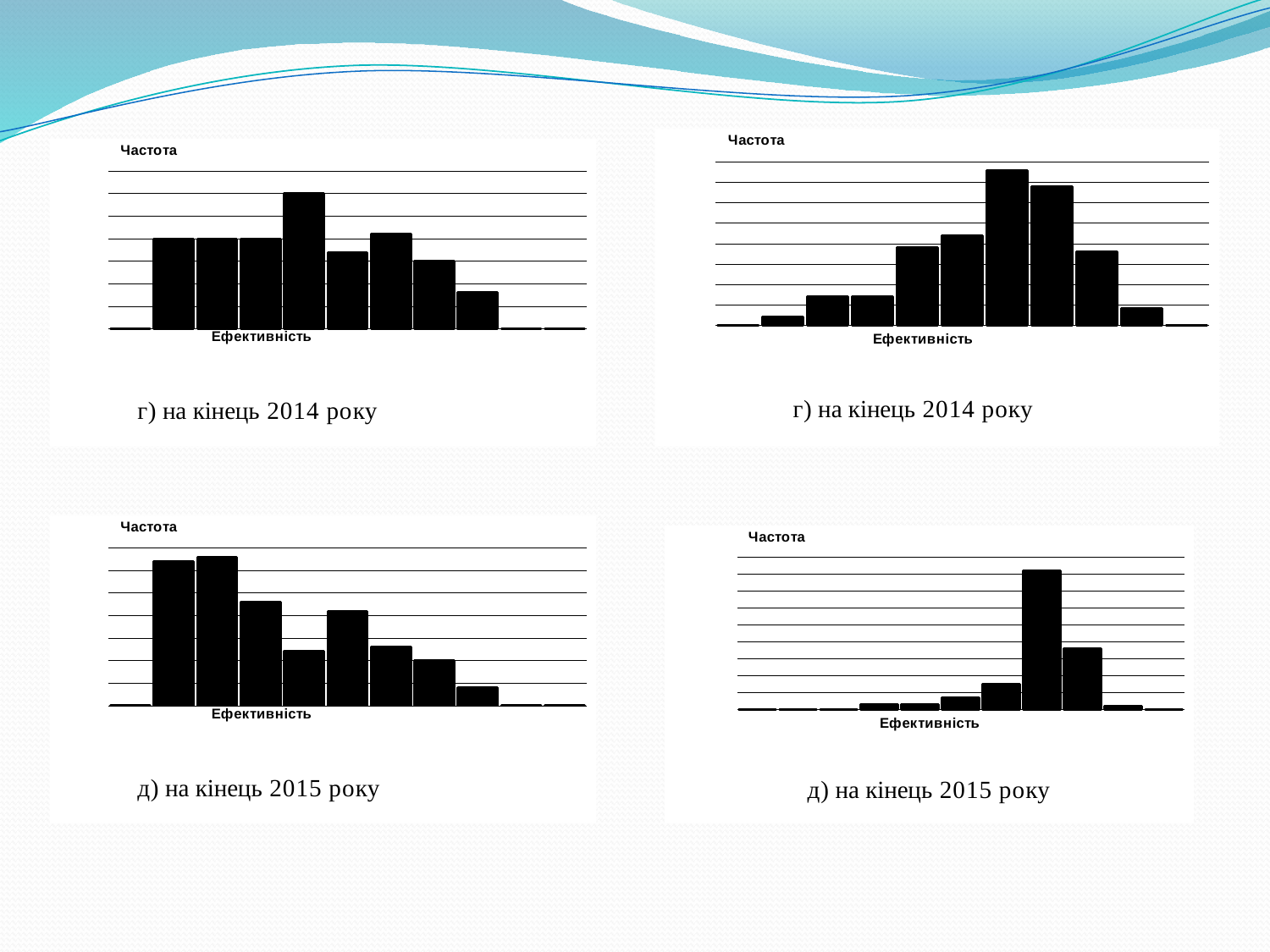
In the bottom-left chart (д, 2015), which bar is the tallest? the second bar from the left What is the label on the vertical axis of the top-left chart? Частота In the top-left chart (г, 2014), which bar is the tallest? the fourth bar from the left How many bars with visible height are plotted in the bottom-left chart (д, 2015)? 8 How many bars with visible height are plotted in the top-left chart (г, 2014)? 8 What kind of chart is the top-left chart captioned 'г) на кінець 2014 року'? bar chart What is the label on the horizontal axis of the bottom-right chart? Ефективність In the bottom-left chart (д, 2015), which is taller: the third bar from the left or the fifth bar from the left? the third bar In the top-right chart (г, 2014), which bar is the tallest? the sixth bar from the left In the top-right chart (г, 2014), which is taller: the second bar from the left or the eighth bar from the left? the eighth bar How many bars with visible height are plotted in the top-right chart (г, 2014)? 9 In the top-right chart (г, 2014), which visible bar is the shortest? the first (leftmost) bar